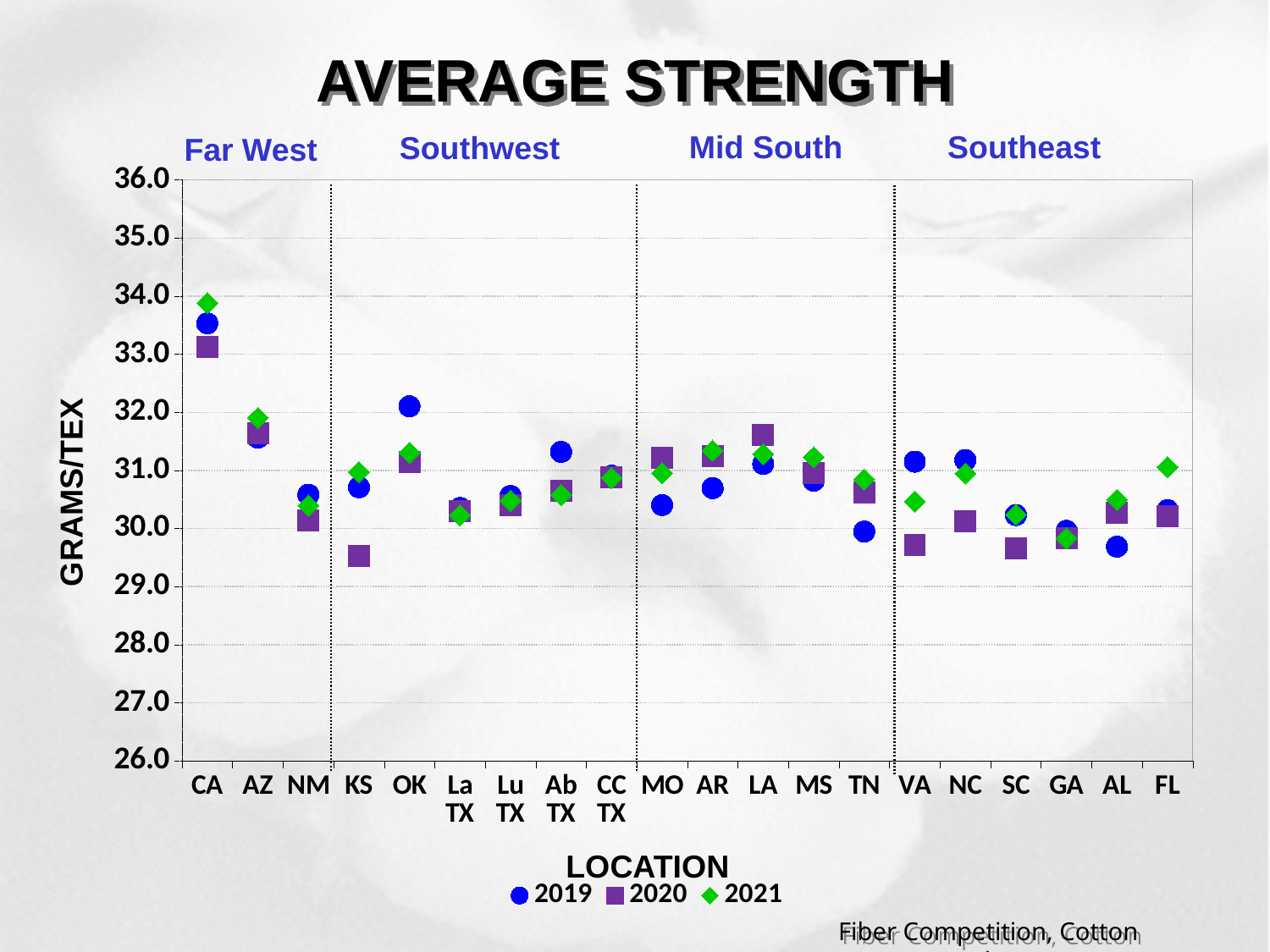
Which location has the highest 2019 average strength? CA Is the 2020 value for VA greater or less than 30.0? less Which is larger, the 2019 value for CA or the 2019 value for AZ? CA Is the 2020 value for KS greater or less than 30.0? less Which is larger for KS, the 2020 value or the 2021 value? 2021 Is the 2019 value for OK greater or less than 31.0? greater How many locations are plotted along the x axis? 20 Which location has the highest 2021 average strength? CA What kind of chart is shown on the slide? scatter chart How many series does the legend list? 3 What is the title of the y axis? GRAMS/TEX